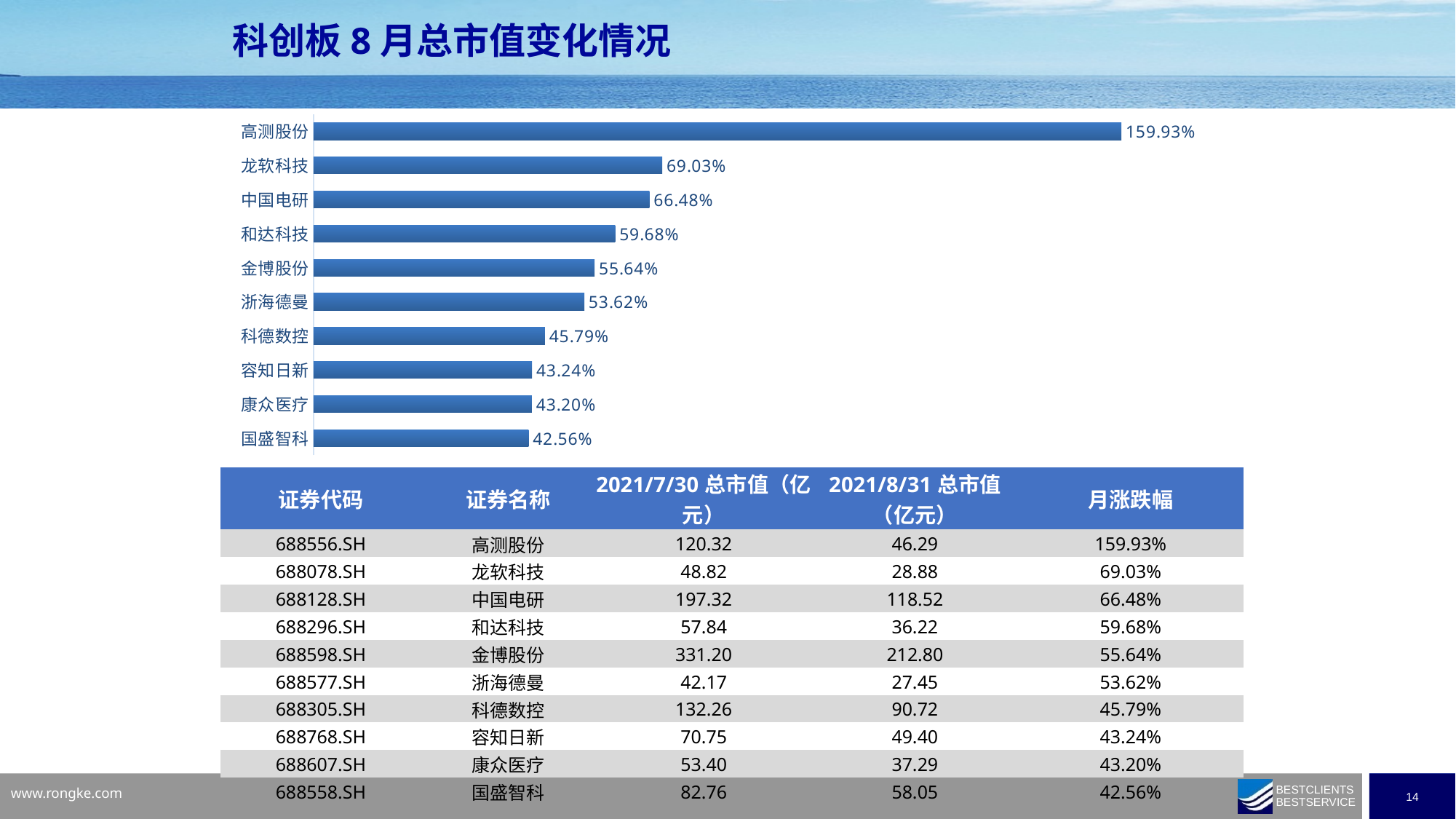
How many categories are shown in the bar chart? 10 Which has a larger value, 和达科技 or 金博股份? 和达科技 What is the value for 浙海德曼 in the bar chart? 53.62% Which category has the highest value in the bar chart? 高测股份 Which category has the lowest value in the bar chart? 国盛智科 What is the difference between the values for 高测股份 and 龙软科技? 90.90% What is the title of the slide? 科创板 8 月总市值变化情况 What kind of chart is shown on the slide? Bar chart What is the difference between the values for 龙软科技 and 中国电研? 2.55% What is the value for 高测股份 in the bar chart? 159.93% What is the value for 国盛智科 in the bar chart? 42.56% Which has a larger value, 科德数控 or 容知日新? 科德数控